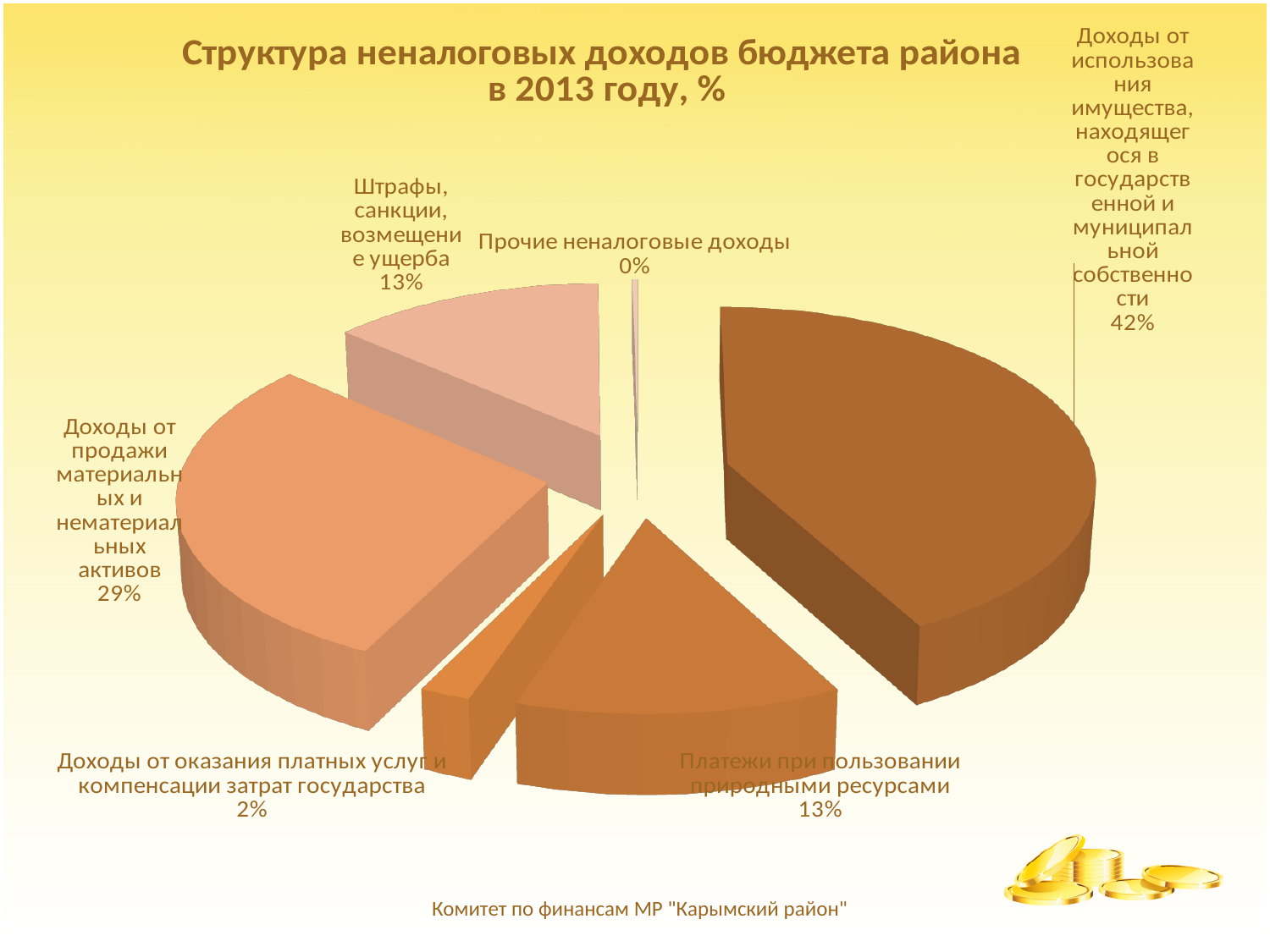
What is the title of the chart? Структура неналоговых доходов бюджета района в 2013 году, % Which category has the largest share of the pie? Доходы от использования имущества, находящегося в государственной и муниципальной собственности What is the difference in percentage points between 'Доходы от использования имущества...' (42%) and 'Доходы от продажи материальных и нематериальных активов' (29%)? 13 How many slices does the pie chart have? 6 What share of the pie is 'Доходы от использования имущества, находящегося в государственной и муниципальной собственности'? 42% Which category has the smallest share of the pie? Прочие неналоговые доходы What share of the pie is 'Доходы от продажи материальных и нематериальных активов'? 29% Which is larger: the share for 'Доходы от продажи материальных и нематериальных активов' or the share for 'Штрафы, санкции, возмещение ущерба'? Доходы от продажи материальных и нематериальных активов What is the value shown for 'Доходы от оказания платных услуг и компенсации затрат государства'? 2% What is the value shown for 'Прочие неналоговые доходы'? 0% What kind of chart is shown on the slide? Pie chart What is the value shown for 'Платежи при пользовании природными ресурсами'? 13%